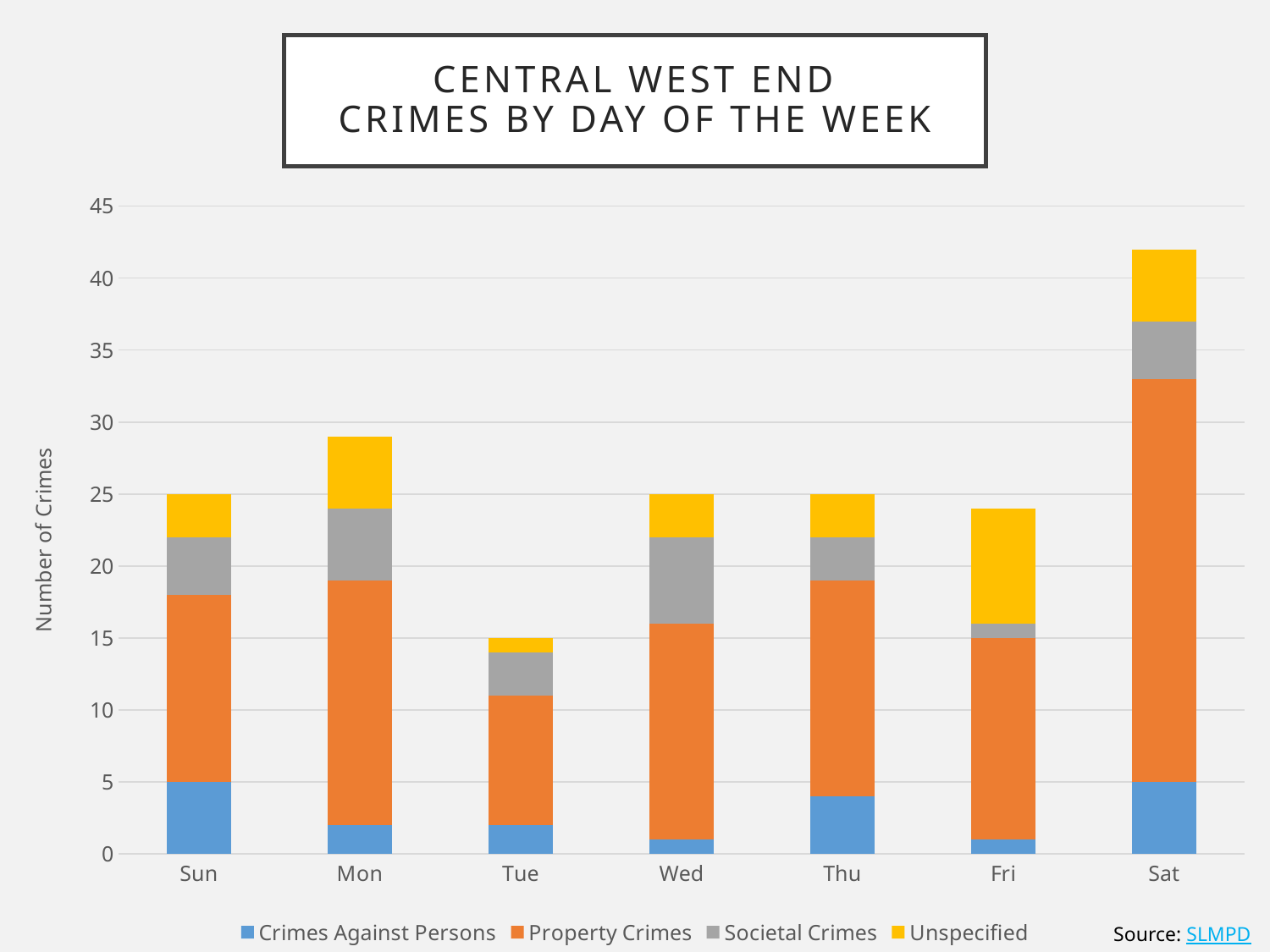
What is the title of the chart? Central West End Crimes by Day of the Week What is the total number of crimes on Sun? 25 Is the total number of crimes on Mon greater or less than 25? greater What kind of chart is shown on the slide? Stacked bar chart Is the total number of crimes on Tue greater or less than 20? less How many series does the legend list? 4 Which day has a higher total number of crimes, Mon or Fri? Mon Which day has the lowest total number of crimes? Tue Is the total number of crimes on Sat greater or less than 40? greater Which colour represents Unspecified crimes in the legend? Yellow Which day has the highest total number of crimes? Sat How many days of the week are shown on the x axis? 7